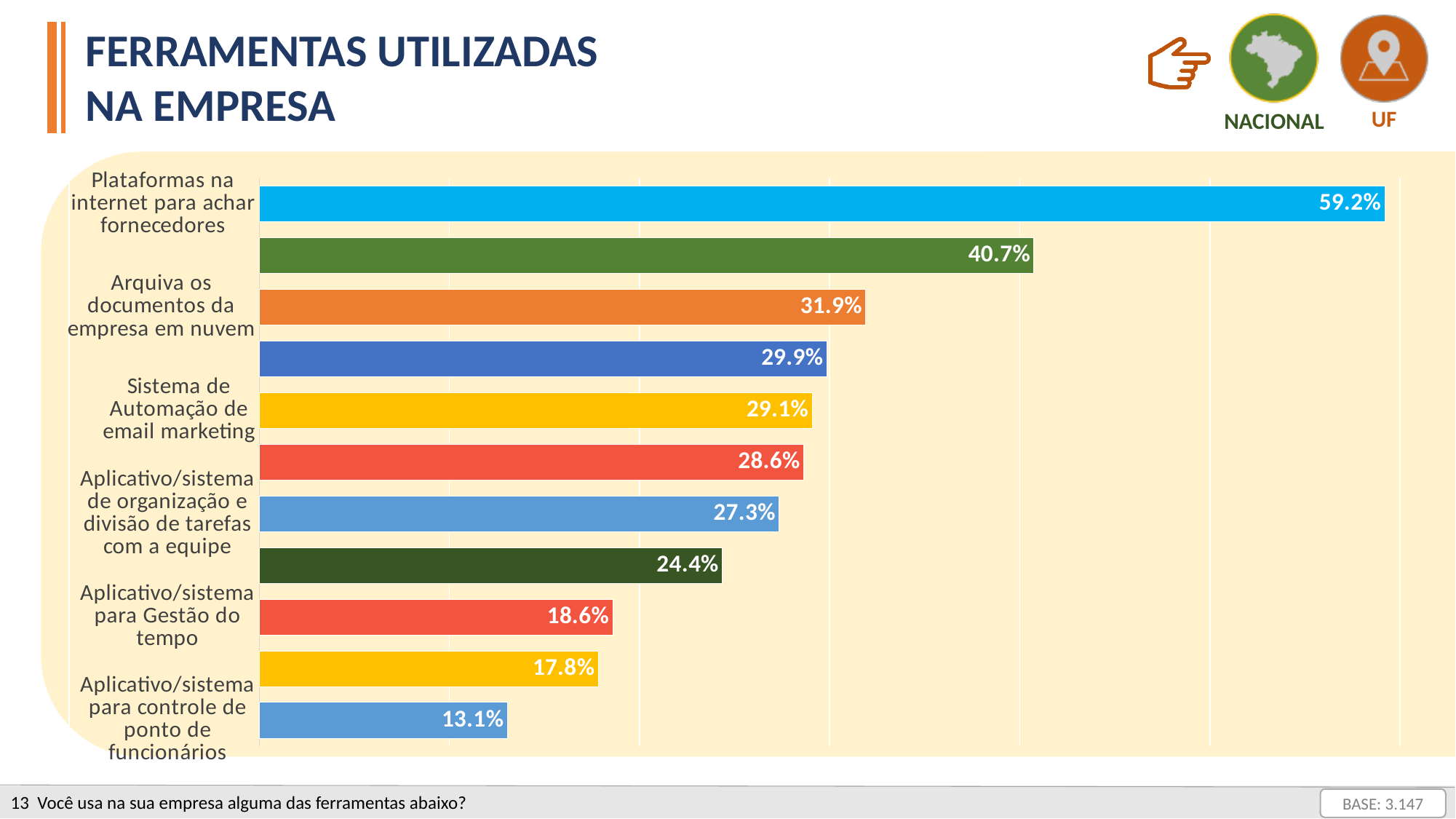
What kind of chart is shown on the slide? Bar chart How many bars are plotted in the chart? 11 Which category has the lowest value? Aplicativo/sistema para controle de ponto de funcionários What is the difference between the values for "Plataformas na internet para achar fornecedores" and "Arquiva os documentos da empresa em nuvem"? 27.3% Which is larger: the value for "Aplicativo/sistema de organização e divisão de tarefas com a equipe" or for "Aplicativo/sistema para Gestão do tempo"? Aplicativo/sistema de organização e divisão de tarefas com a equipe What is the value for "Arquiva os documentos da empresa em nuvem"? 31.9% Which category has the highest value? Plataformas na internet para achar fornecedores What is the title of the slide? FERRAMENTAS UTILIZADAS NA EMPRESA What is the value for "Aplicativo/sistema para Gestão do tempo"? 18.6% What is the value for "Plataformas na internet para achar fornecedores"? 59.2% What is the value for "Aplicativo/sistema para controle de ponto de funcionários"? 13.1% What is the value for "Sistema de Automação de email marketing"? 29.1%